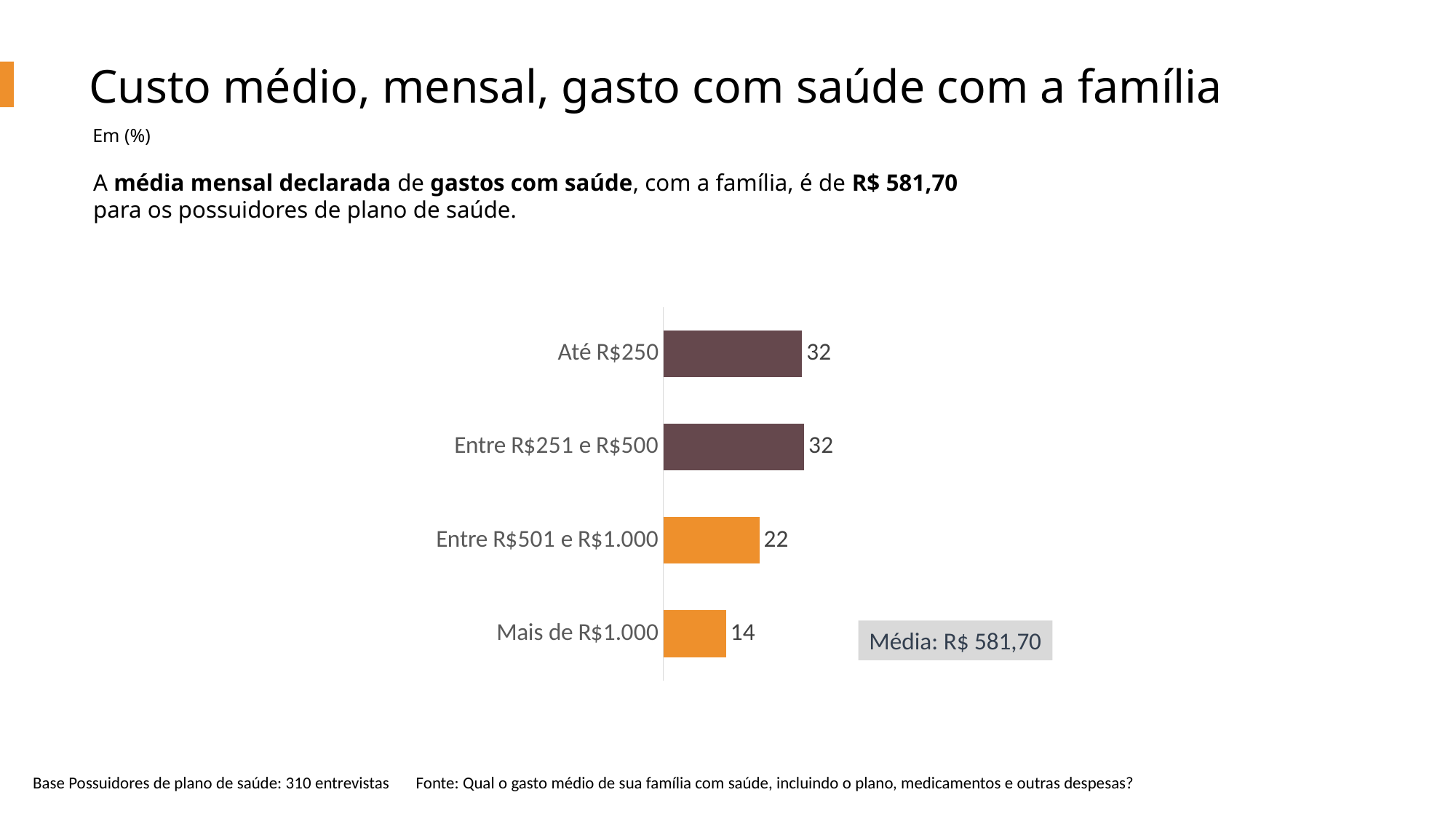
What is the title of the slide? Custo médio, mensal, gasto com saúde com a família What is the value for 'Até R$250'? 32 What is the difference between the values for 'Até R$250' and 'Entre R$501 e R$1.000'? 10 What is the difference between the values for 'Entre R$501 e R$1.000' and 'Mais de R$1.000'? 8 What kind of chart is shown on the slide? Bar chart What is the value for 'Entre R$251 e R$500'? 32 What average value (Média) is shown in the box next to the chart? R$ 581,70 How many categories are shown in the chart? 4 What is the value for 'Entre R$501 e R$1.000'? 22 Which is larger, the value for 'Entre R$251 e R$500' or the value for 'Mais de R$1.000'? Entre R$251 e R$500 Which category has the lowest value? Mais de R$1.000 What is the value for 'Mais de R$1.000'? 14